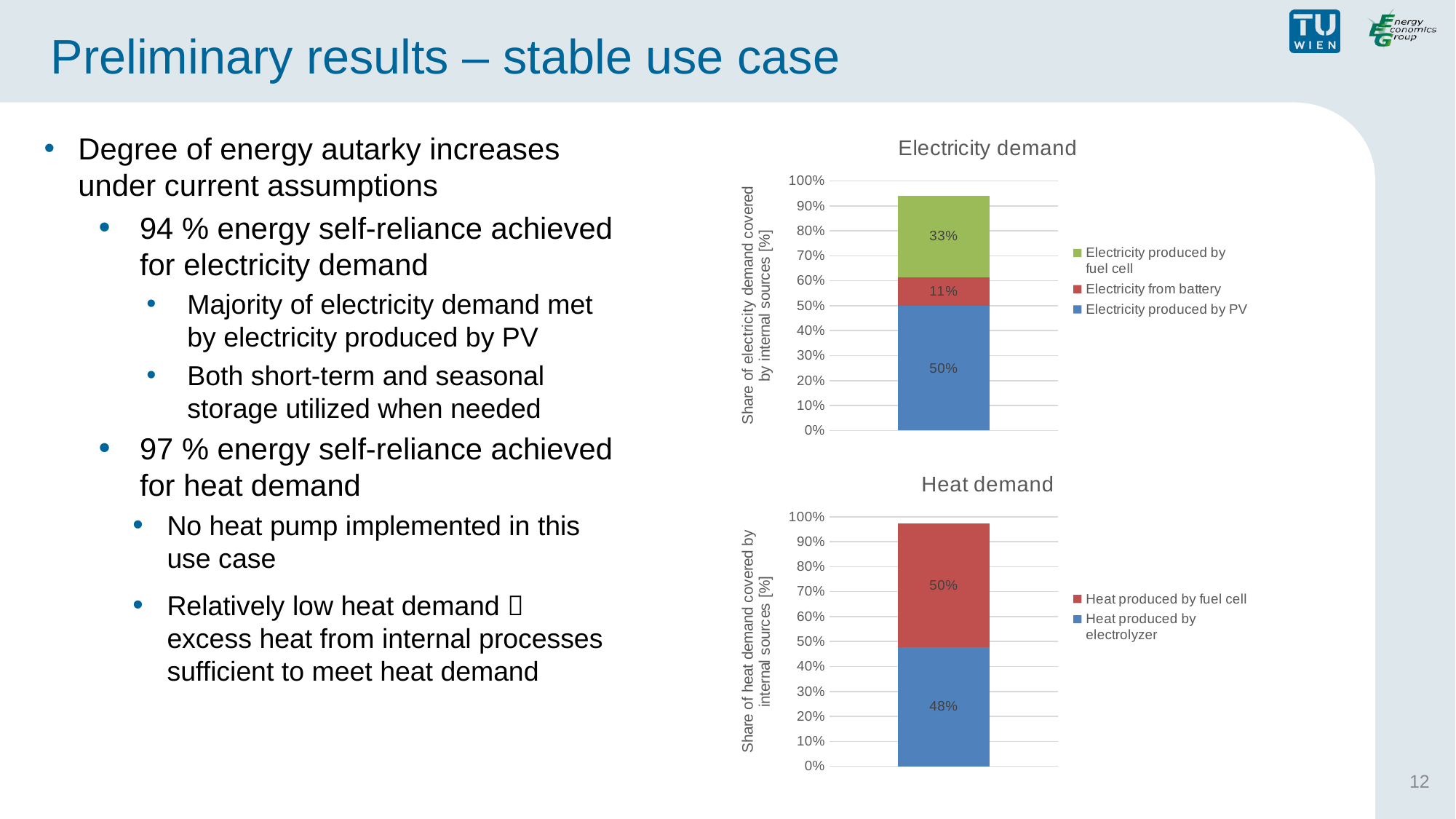
In the Heat demand chart, what share of heat demand is covered by heat produced by fuel cell? 50% In the Electricity demand chart, which series has the smallest share? Electricity from battery In the Electricity demand chart, what share of electricity demand is covered by electricity produced by PV? 50% In the Electricity demand chart, which series has the largest share? Electricity produced by PV In the Electricity demand chart, what share of electricity demand is covered by electricity produced by fuel cell? 33% In the Electricity demand chart, what is the total share of electricity demand covered by internal sources (the full stacked bar)? 94% In the Electricity demand chart, what share of electricity demand is covered by electricity from battery? 11% In the Electricity demand chart, what is the difference between the share from PV and the share from the fuel cell? 17% In the Heat demand chart, what share of heat demand is covered by heat produced by electrolyzer? 48% What type of chart is the Electricity demand chart? Stacked bar chart How many series does the legend of the Heat demand chart list? 2 In the Electricity demand chart, is the share from the fuel cell larger or smaller than the share from the battery? larger